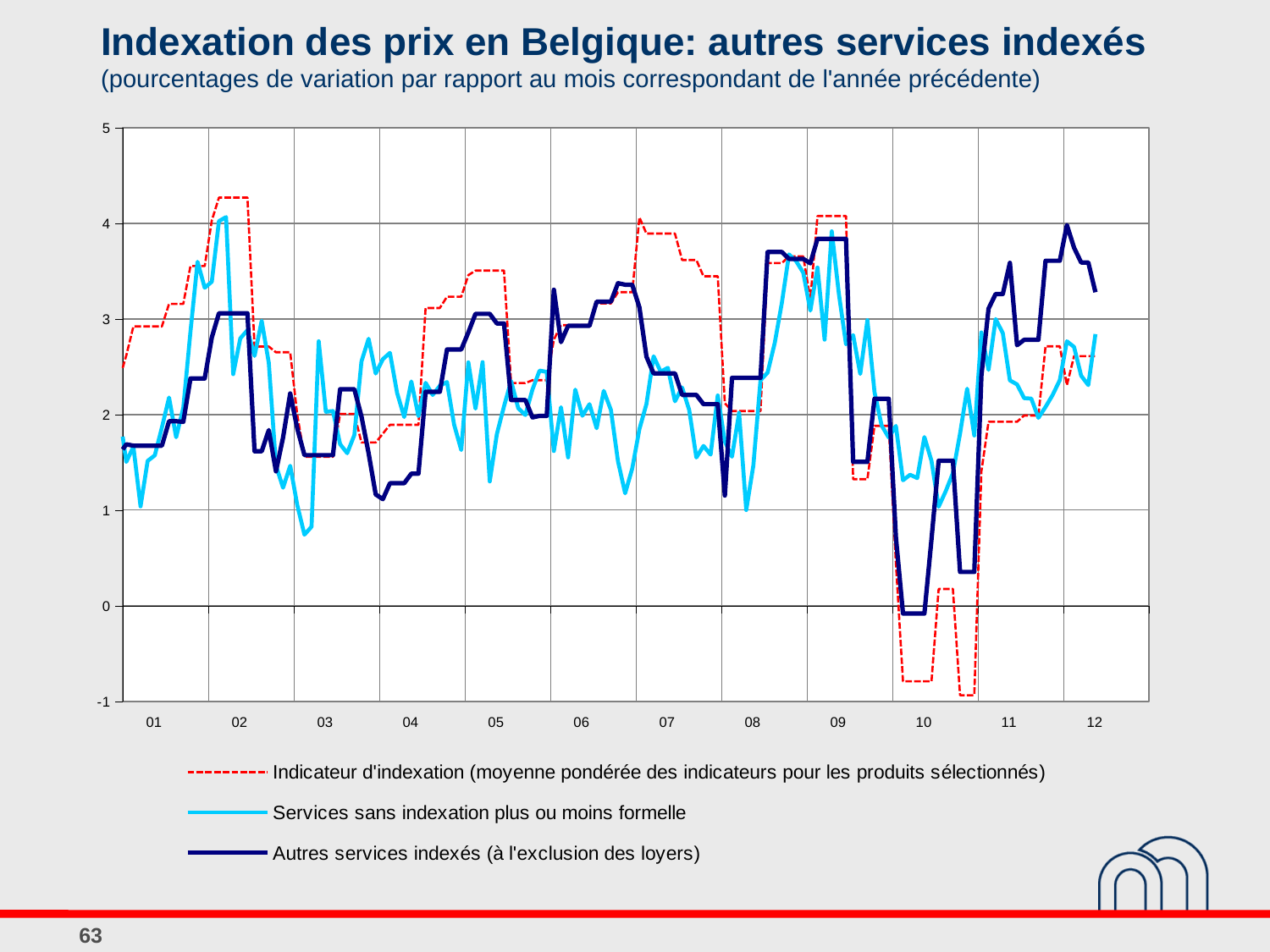
Is the lowest value of the dashed red 'Indicateur d'indexation' line, reached around 2010, greater or less than 0? less What is the title of the chart? Indexation des prix en Belgique: autres services indexés Which series is drawn as a dashed red line? Indicateur d'indexation (moyenne pondérée des indicateurs pour les produits sélectionnés) What is the highest value shown on the y axis? 5 How many year labels are shown along the x axis? 12 Is the lowest value of the light blue 'Services sans indexation plus ou moins formelle' line, reached around 2003, greater or less than 1? less What kind of chart is shown on the slide? line chart How many series does the legend list? 3 Is the peak of the dashed red 'Indicateur d'indexation' line in 2002 greater or less than 4? greater Does the dashed red 'Indicateur d'indexation' line rise or fall between 2007 and 2008? fall Does the dark blue 'Autres services indexés' line rise or fall between 2010 and 2011? rise